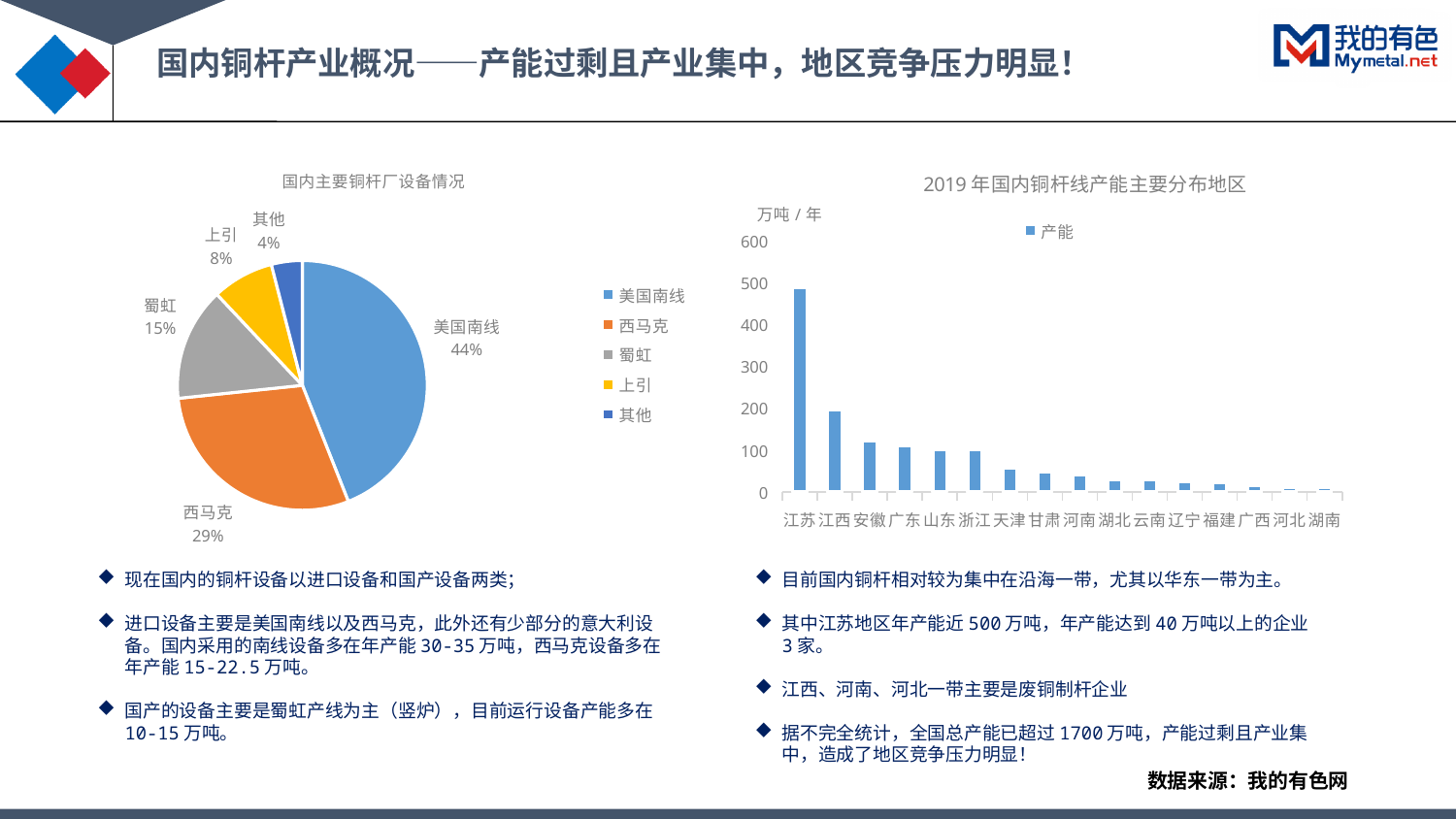
In the pie chart 国内主要铜杆厂设备情况, what share does 蜀虹 have? 15% In the pie chart 国内主要铜杆厂设备情况, which category has the smallest share? 其他 In the chart 2019年国内铜杆线产能主要分布地区, how many regions are shown on the x axis? 16 In the pie chart 国内主要铜杆厂设备情况, what is the difference in percentage points between 美国南线 and 西马克? 15 In the chart 2019年国内铜杆线产能主要分布地区, which region has the highest capacity? 江苏 In the chart 2019年国内铜杆线产能主要分布地区, is the value for 江苏 greater or less than 400? greater In the pie chart 国内主要铜杆厂设备情况, which category has the largest share? 美国南线 What type of chart is 2019年国内铜杆线产能主要分布地区? bar chart In the chart 2019年国内铜杆线产能主要分布地区, is the value for 江西 greater or less than 300? less In the chart 2019年国内铜杆线产能主要分布地区, do the values rise or fall from left to right along the x axis? fall In the pie chart 国内主要铜杆厂设备情况, what share does 美国南线 have? 44% In the pie chart 国内主要铜杆厂设备情况, how many slices are there? 5